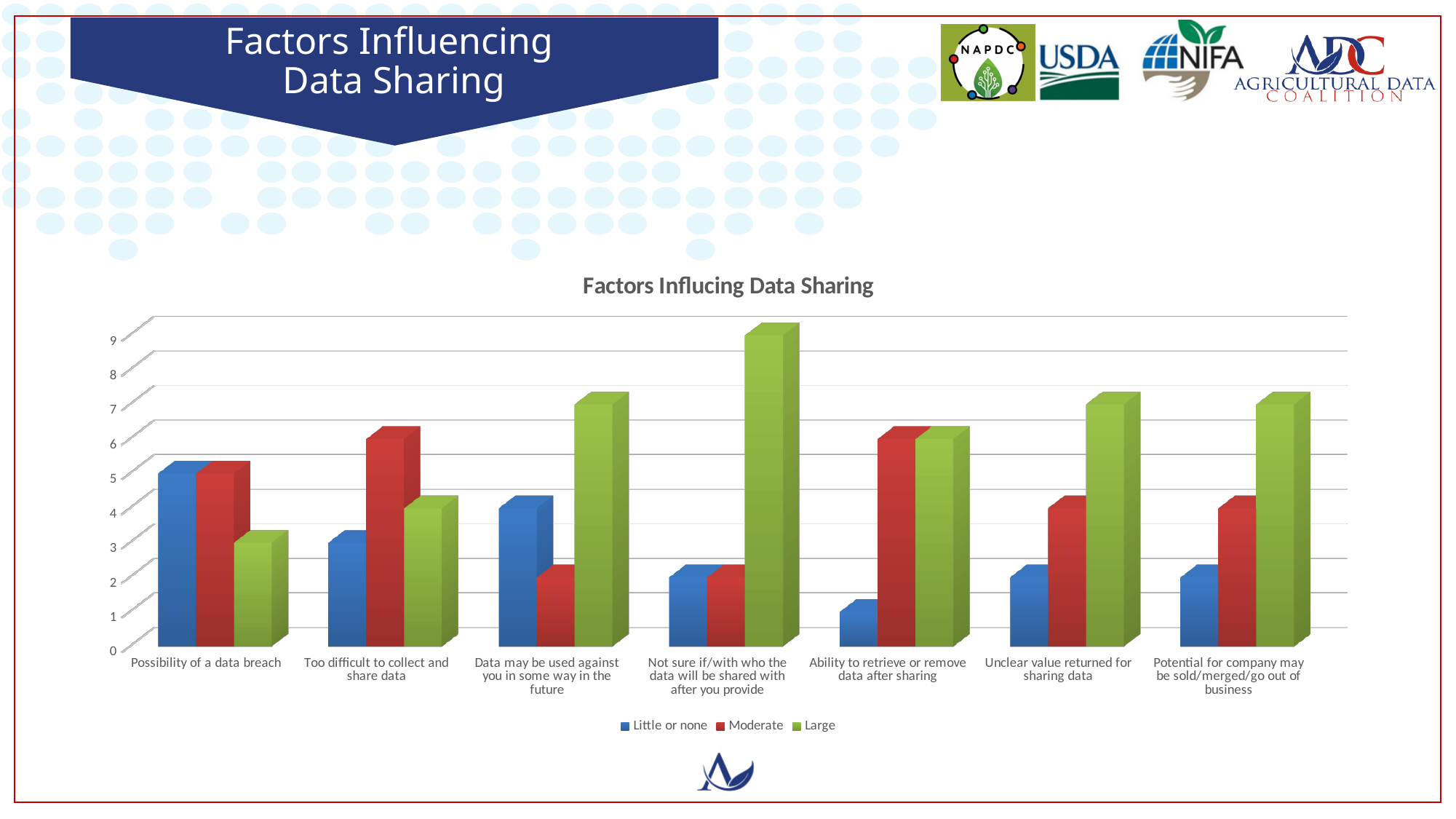
Which category has the lowest value for the Large series? Possibility of a data breach What colour represents the Large series in the legend? green Which category has the lowest value for the Little or none series? Ability to retrieve or remove data after sharing Is the Moderate value for 'Data may be used against you in some way in the future' greater or less than 3? less How many series does the legend list? 3 What kind of chart is shown on the slide? bar chart For 'Data may be used against you in some way in the future', which is larger: the Little or none value or the Large value? Large Which category has the highest value for the Large series? Not sure if/with who the data will be shared with after you provide For 'Too difficult to collect and share data', which is larger: the Moderate value or the Large value? Moderate Is the Large value for 'Not sure if/with who the data will be shared with after you provide' greater or less than 8? greater How many categories are shown along the x axis? 7 Is the Little or none value for 'Possibility of a data breach' greater or less than 4? greater